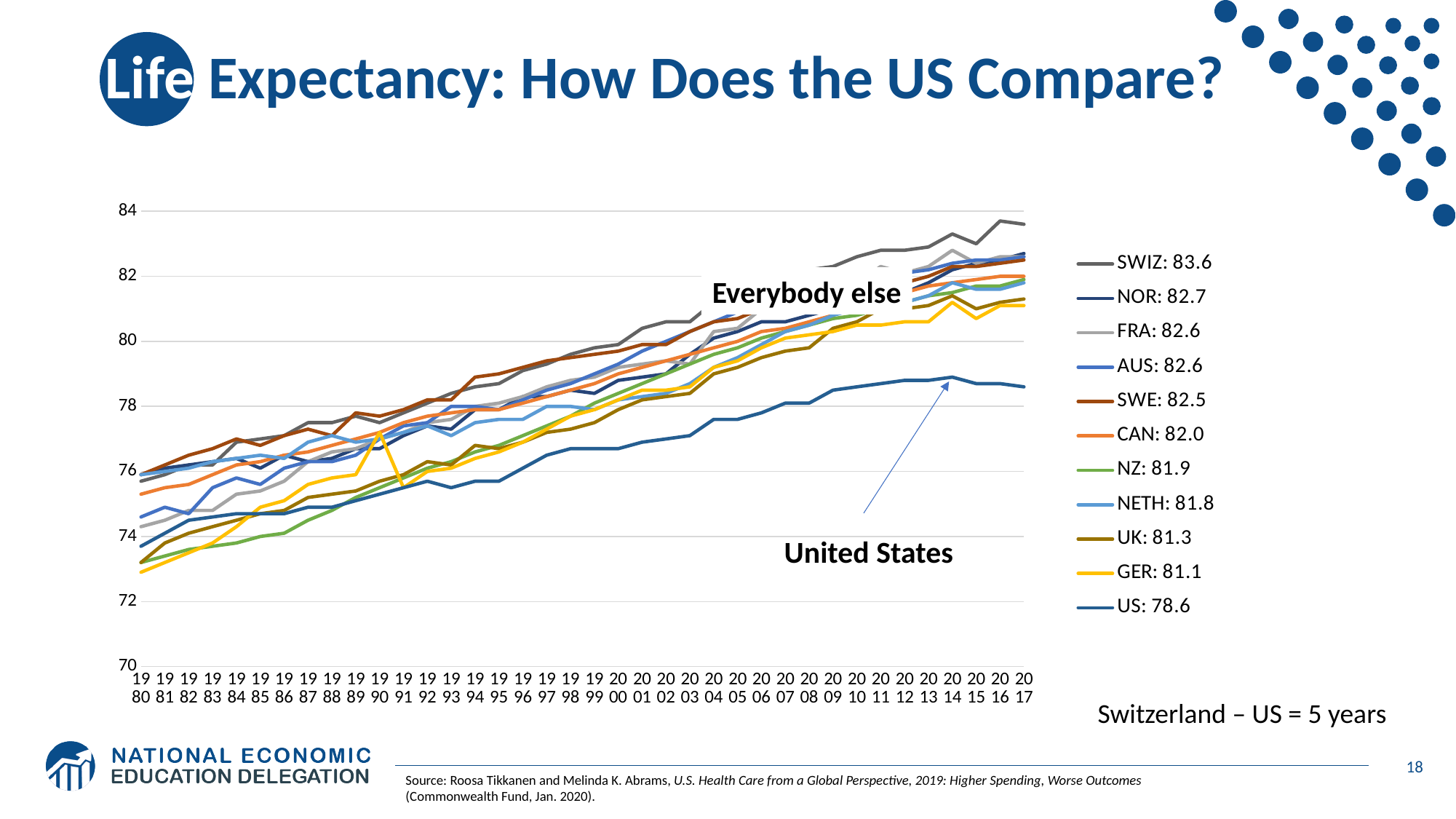
Is the US line in 2017 greater or less than 80? less Which has the larger legend value, CAN or NZ? CAN How many series does the legend list? 11 What value is shown for UK in the legend? 81.3 What kind of chart is shown on the slide? line chart Do the life expectancy lines generally rise or fall from 1980 to 2017? rise What is the difference between the SWIZ value and the US value shown in the legend? 5 What life expectancy value is shown for US in the legend? 78.6 What life expectancy value is shown for SWIZ in the legend? 83.6 Which country has the lowest life expectancy value in the legend? US What is the difference between the NOR value and the US value shown in the legend? 4.1 Which country has the highest life expectancy value in the legend? SWIZ